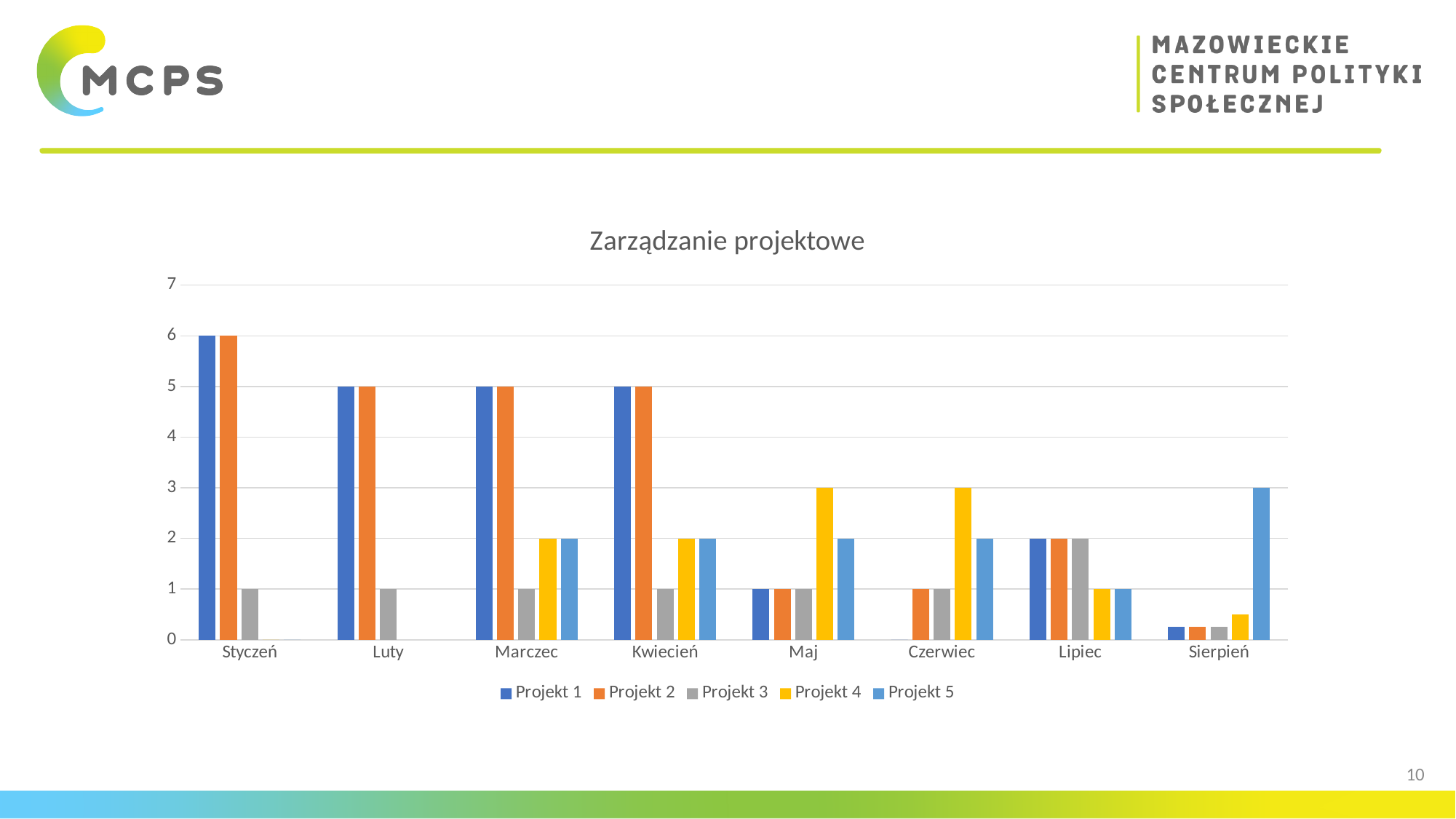
How many series does the legend list? 5 What is the value for Projekt 1 in Styczeń? 6 What type of chart is shown on the slide? bar chart What is the value for Projekt 3 in Lipiec? 2 How many months are shown on the x axis? 8 In which month is the value for Projekt 1 highest? Styczeń In which month is the value for Projekt 5 highest? Sierpień What is the value for Projekt 4 in Maj? 3 What is the title of the chart? Zarządzanie projektowe What is the difference between Projekt 1 in Styczeń and Projekt 1 in Luty? 1 Is the value for Projekt 5 in Sierpień greater or less than 2? greater Which is larger: Projekt 4 in Czerwiec or Projekt 5 in Czerwiec? Projekt 4